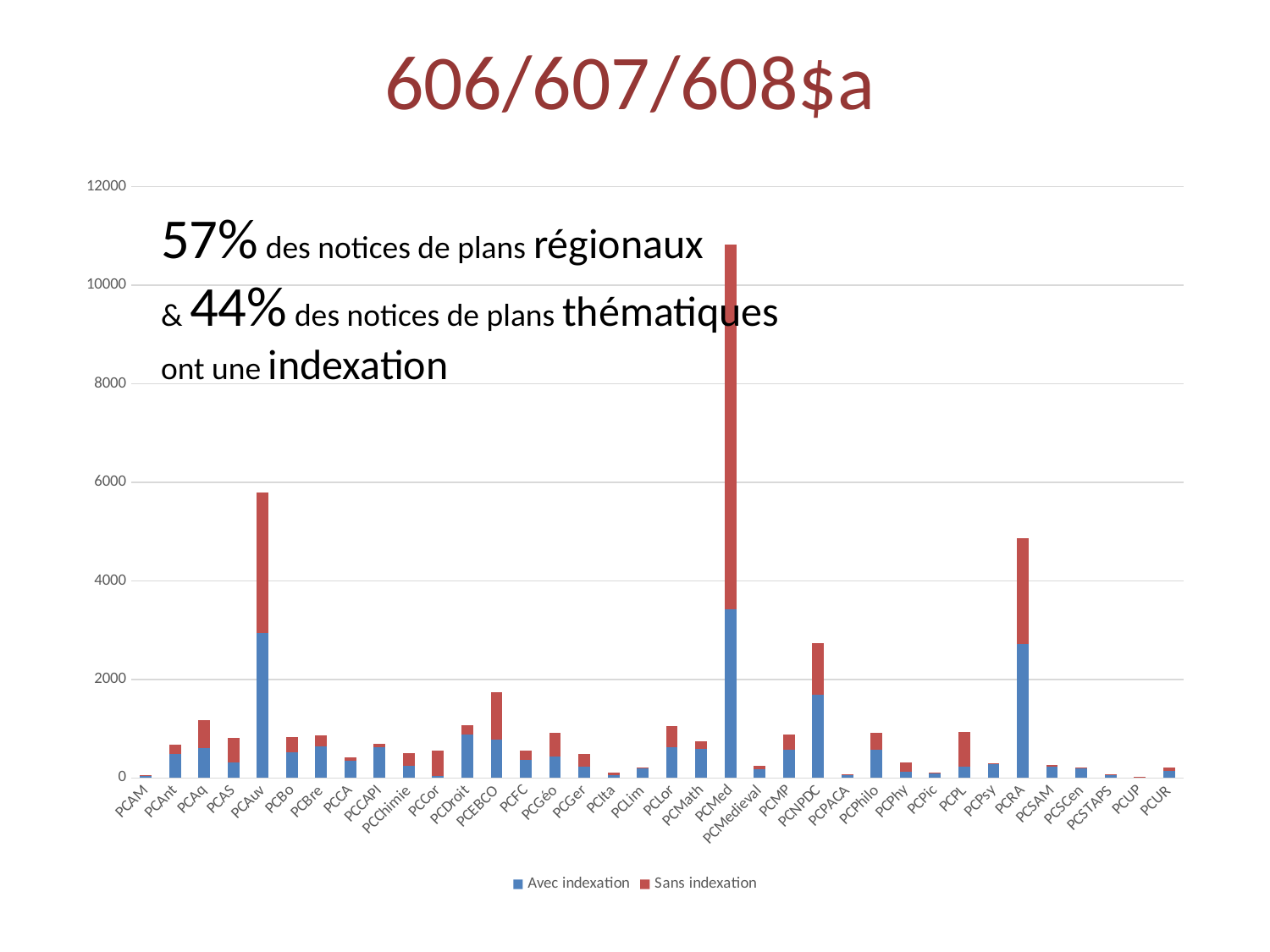
What is the title of the slide containing the chart? 606/607/608$a Is the total stacked value for PCNPDC greater or less than 2000? greater Is the total stacked value for PCAuv greater or less than 6000? less Which category has the tallest stacked bar? PCMed Is the total stacked value for PCMed greater or less than 10000? greater How many categories are shown on the x axis? 36 How many series does the legend list? 2 What are the two series named in the legend? Avec indexation, Sans indexation What kind of chart is shown on the slide? bar chart Which has the taller stacked bar, PCEBCO or PCDroit? PCEBCO Which has the taller stacked bar, PCAuv or PCRA? PCAuv